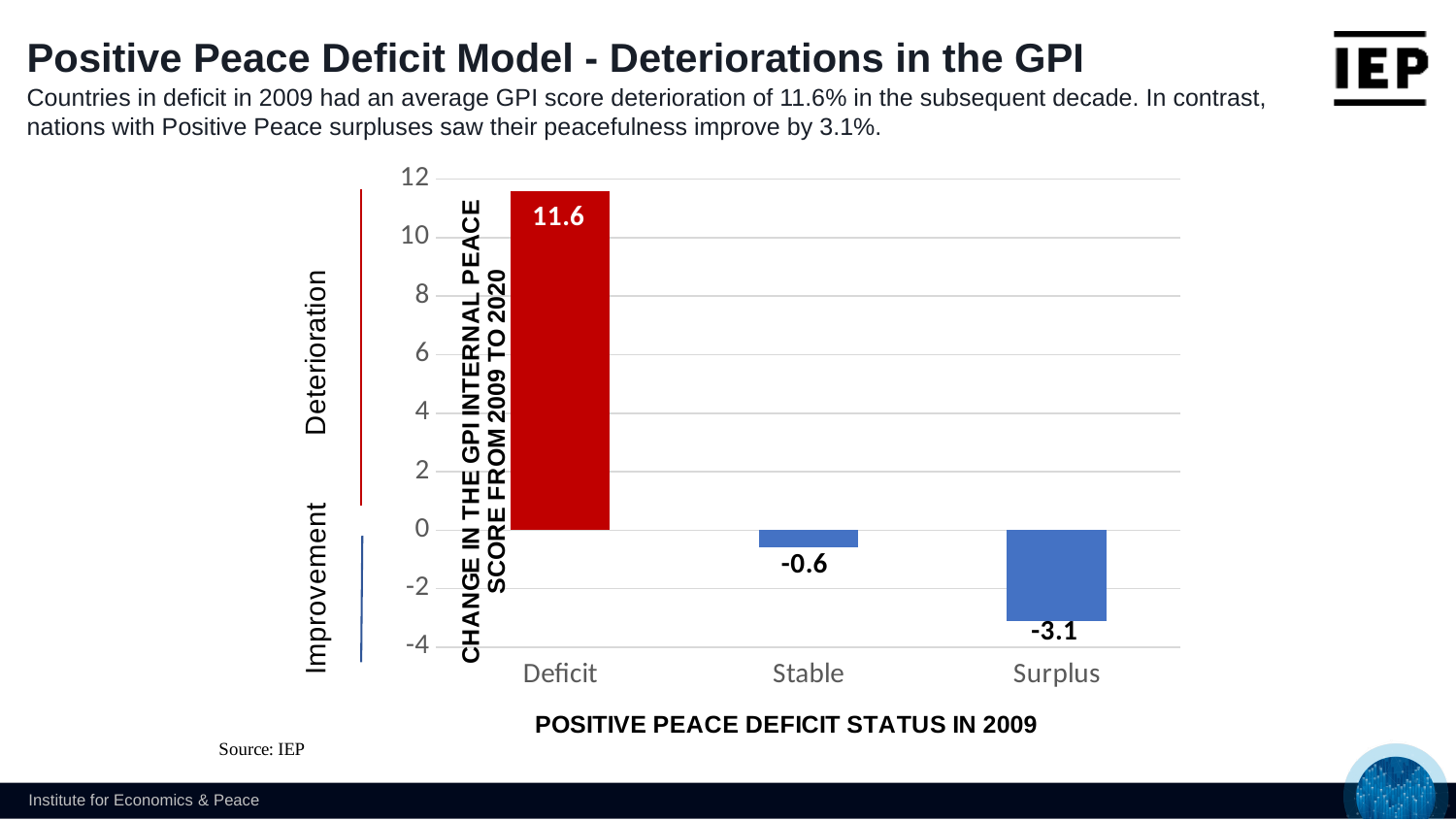
Is the value for Deficit greater or less than 10? greater What is the difference between the values for Stable and Surplus? 2.5 What is the difference between the values for Deficit and Surplus? 14.7 Which category has the highest value? Deficit What is the value for Stable? -0.6 How many categories are shown on the x axis? 3 What is the x-axis title of the chart? POSITIVE PEACE DEFICIT STATUS IN 2009 What is the value for Surplus? -3.1 What is the value for Deficit? 11.6 Which is larger, the value for Stable or the value for Surplus? Stable Which category has the lowest value? Surplus What kind of chart is shown on the slide? bar chart